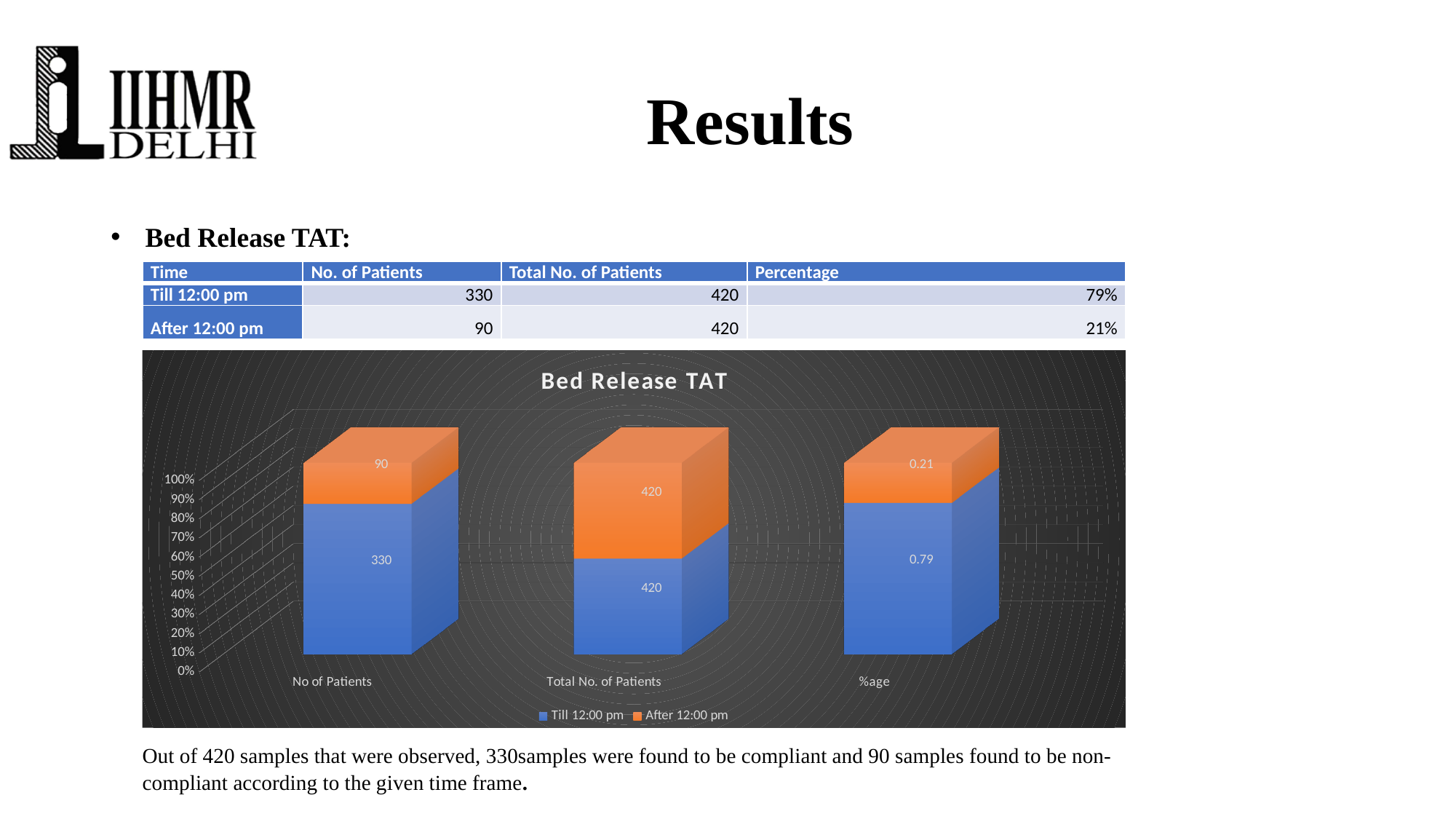
What is the difference between the Till 12:00 pm and After 12:00 pm values for the No of Patients category? 240 How many categories are shown on the x axis of the chart? 3 What type of chart is shown on the slide? Stacked bar chart Which series is shown in orange in the chart? After 12:00 pm What is the value of the After 12:00 pm series for the %age category? 0.21 What is the title of the chart? Bed Release TAT What is the value of the Till 12:00 pm series for the %age category? 0.79 What is the value of the After 12:00 pm series for the Total No. of Patients category? 420 How many series does the chart legend list? 2 For the No of Patients category, which series has the larger value, Till 12:00 pm or After 12:00 pm? Till 12:00 pm What is the value of the Till 12:00 pm series for the No of Patients category? 330 What is the value of the After 12:00 pm series for the No of Patients category? 90